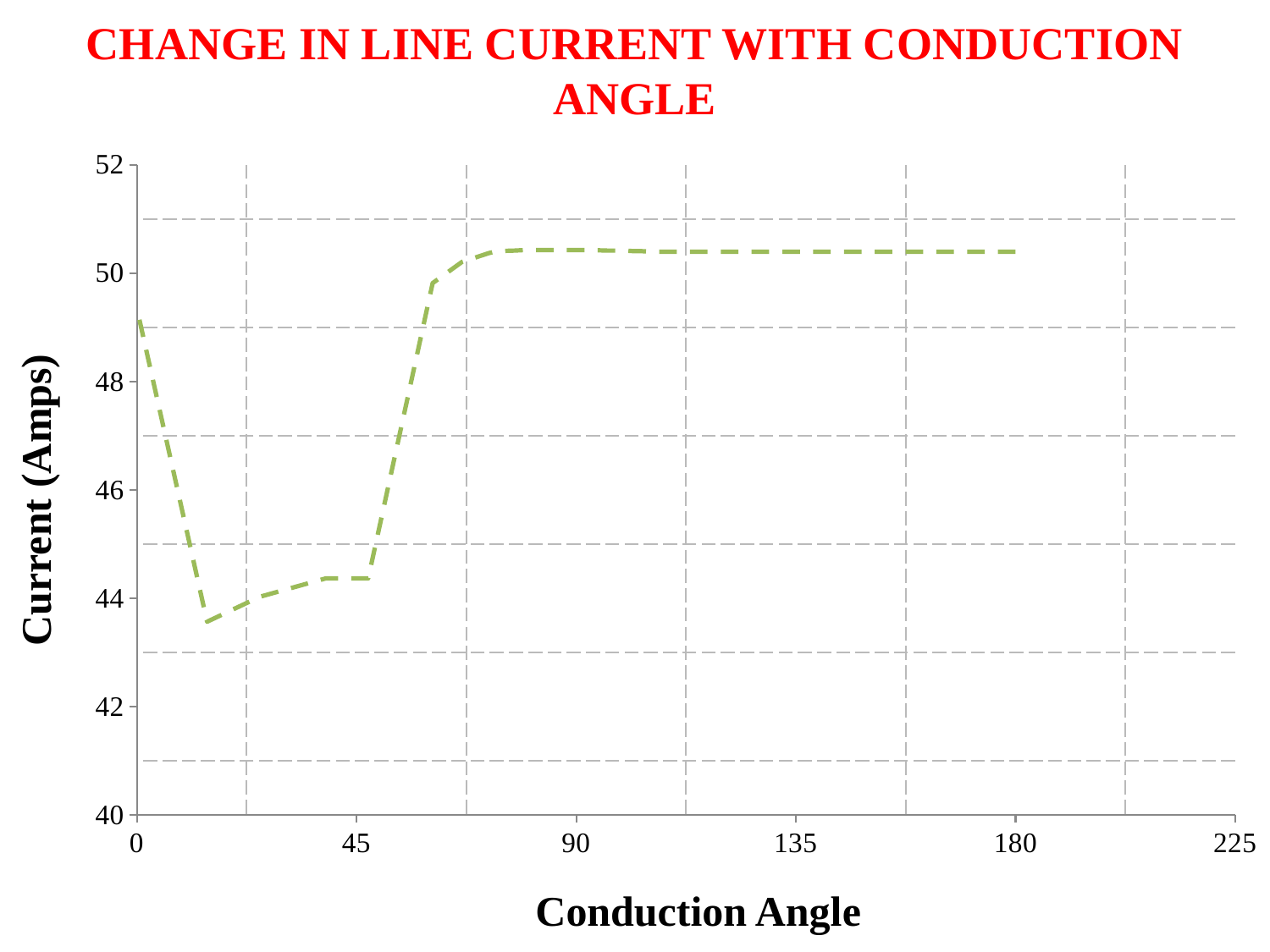
Does the current rise or fall as the conduction angle increases from 0 to about 15? fall Which is larger, the current at a conduction angle of 0 or at 45? 0 Does the lowest current on the chart occur before or after a conduction angle of 45? before Which is larger, the current at a conduction angle of 90 or at 0? 90 What is the title of the chart? CHANGE IN LINE CURRENT WITH CONDUCTION ANGLE What is the label of the vertical axis? Current (Amps) Is the current at a conduction angle of 180 greater or less than 50? greater Is the current at a conduction angle of 45 greater or less than 46? less Does the current rise or fall as the conduction angle increases from 45 to 90? rise Is the current at a conduction angle of 0 greater or less than 48? greater What kind of chart is shown on the slide? line chart